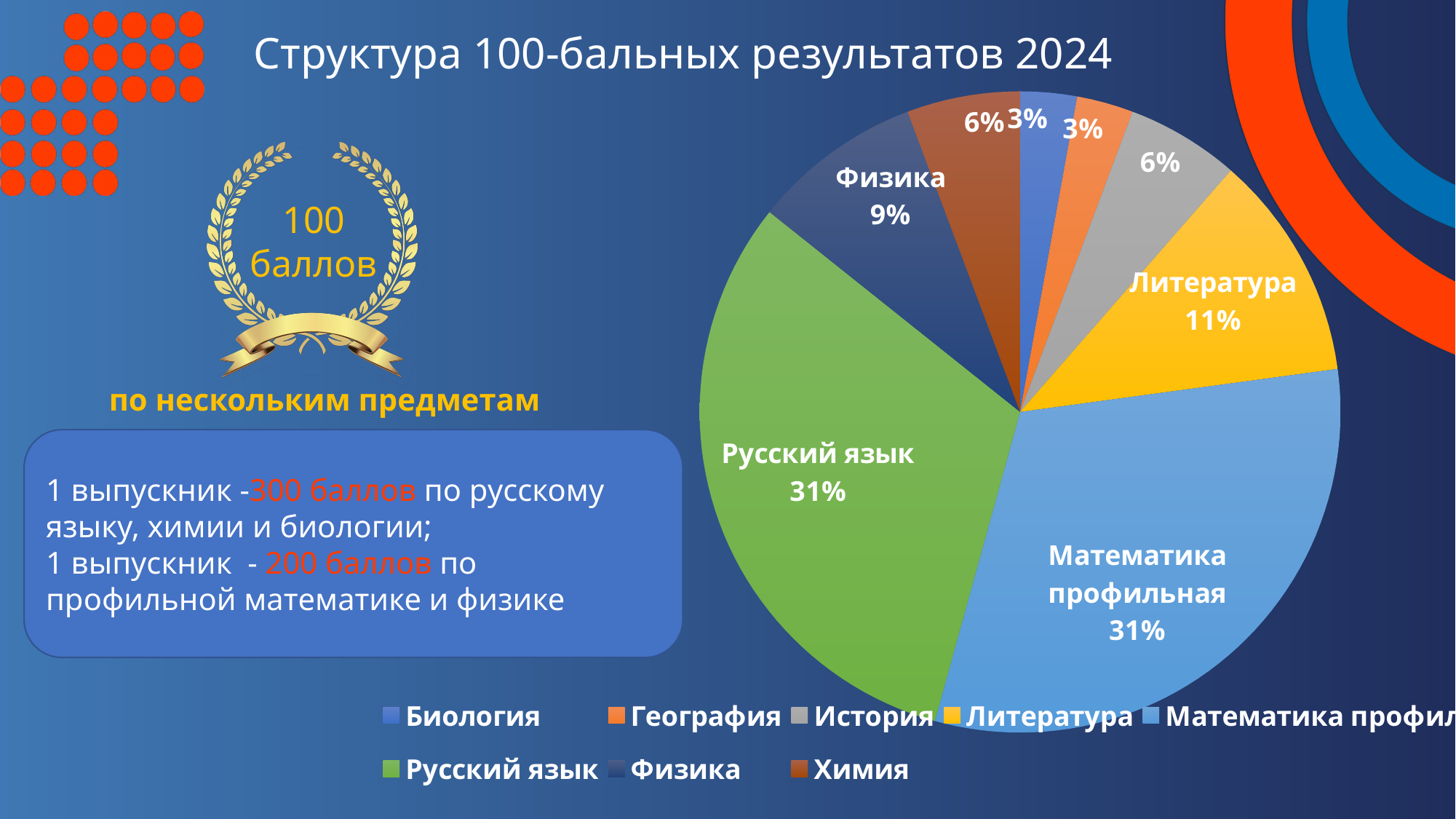
What share of the pie does Литература have? 11% How many entries does the legend list? 8 What share of the pie does Математика профильная have? 31% What share of the pie does История have? 6% What share of the pie does Химия have? 6% What kind of chart is shown on the slide? pie chart How many slices does the pie chart have? 8 What share of the pie does Физика have? 9% Which is larger, the share for Литература or the share for Физика? Литература What is the title of the chart? Структура 100-бальных результатов 2024 What is the difference between the share for Математика профильная and the share for Литература? 20% What share of the pie does Русский язык have? 31%